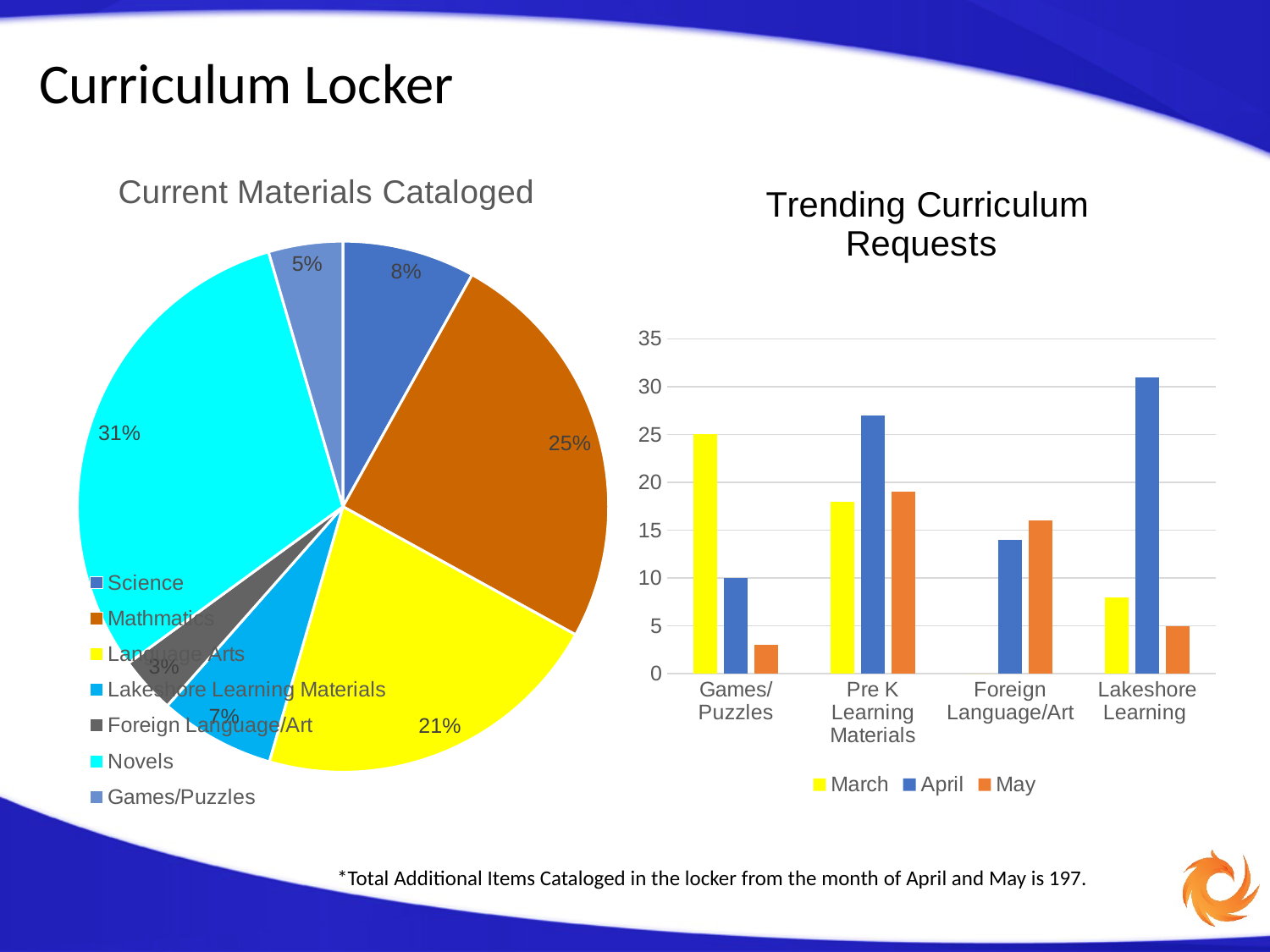
In the Trending Curriculum Requests chart, is the April value for Lakeshore Learning greater or less than 30? greater What kind of chart is Current Materials Cataloged? Pie chart How many categories are shown in the Current Materials Cataloged chart? 7 In the Trending Curriculum Requests chart, which month has the highest value for Pre K Learning Materials? April In the Current Materials Cataloged chart, what percentage is Mathmatics? 25% In the Current Materials Cataloged chart, which category has the smallest share? Foreign Language/Art In the Current Materials Cataloged chart, which is larger, Science or Games/Puzzles? Science In the Current Materials Cataloged chart, how many percentage points larger is Mathmatics than Language Arts? 4 How many series does the legend of the Trending Curriculum Requests chart list? 3 In the Current Materials Cataloged chart, which category has the largest share? Novels In the Current Materials Cataloged chart, what percentage is Novels? 31% In the Trending Curriculum Requests chart, is the May value for Games/Puzzles greater or less than 5? less